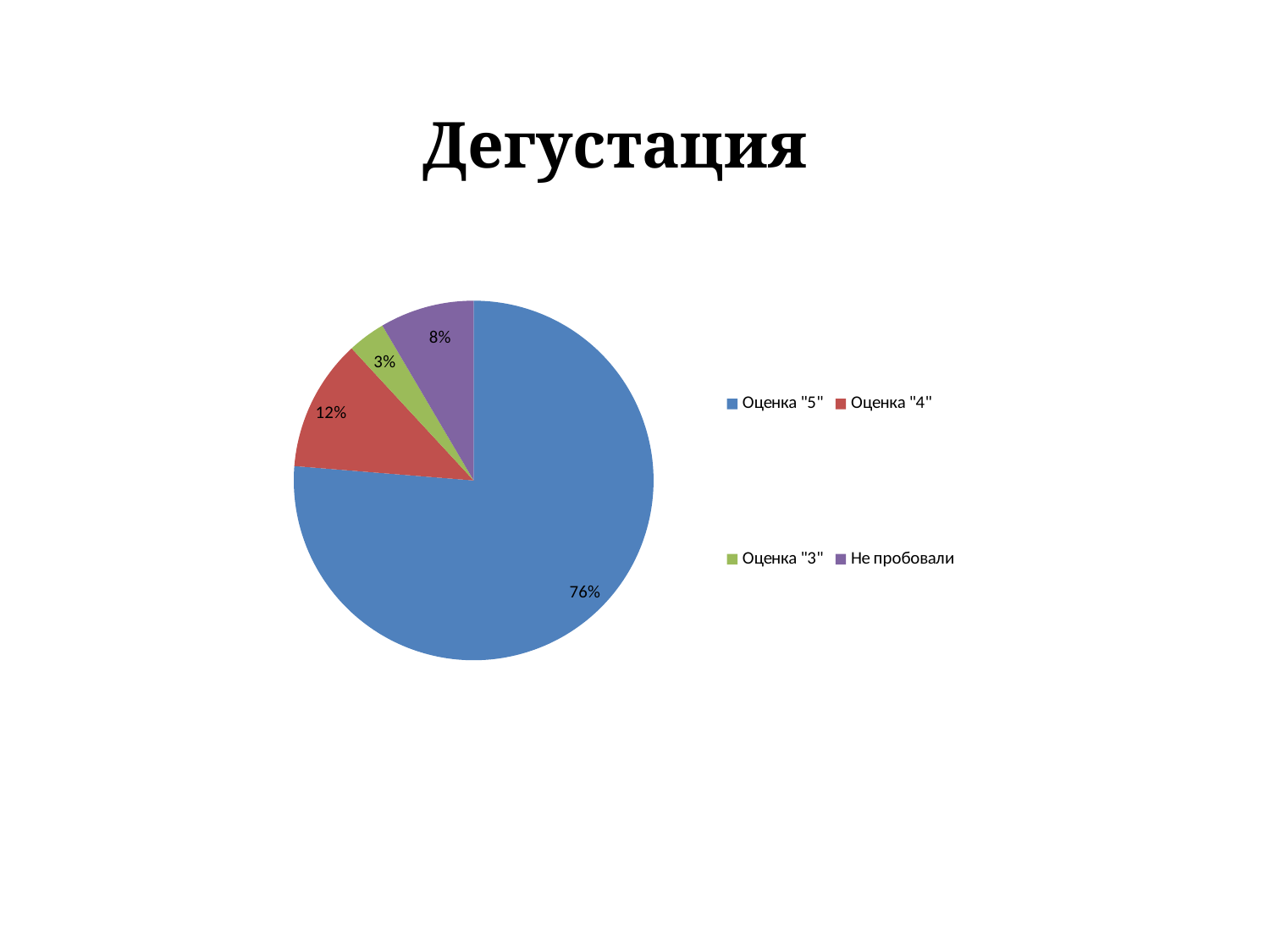
What share of the pie does Оценка "4" have? 12% What share of the pie does Оценка "5" have? 76% What share of the pie does Оценка "3" have? 3% What is the difference in percentage points between Оценка "5" and Оценка "4"? 64 What colour is the slice for Не пробовали? purple What kind of chart is shown on the slide? pie chart What is the title of the slide? Дегустация Which category has the smallest slice of the pie? Оценка "3" Which category has the largest slice of the pie? Оценка "5" How many slices does the pie chart have? 4 Which is larger: the share for Оценка "4" or the share for Не пробовали? Оценка "4"